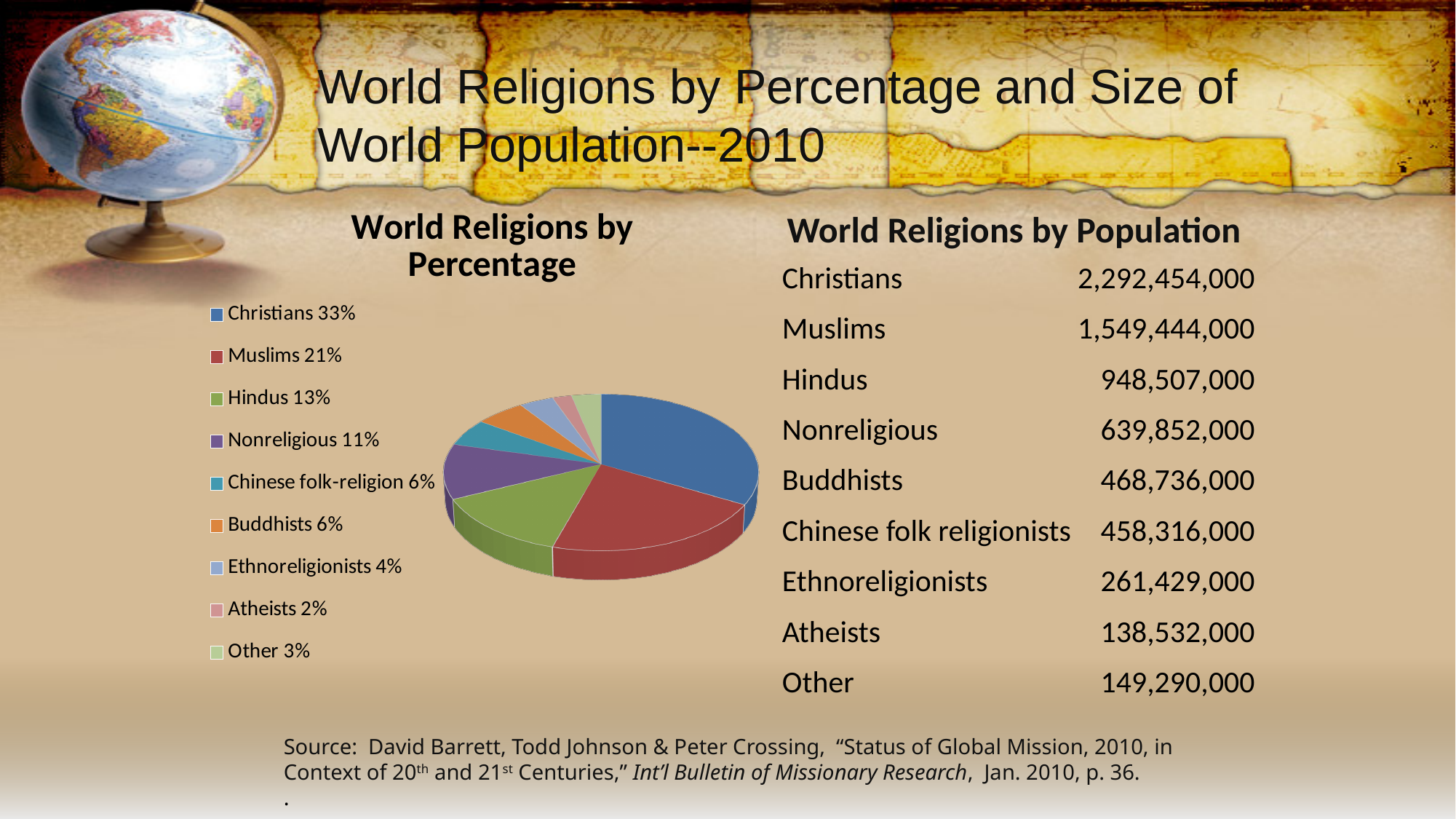
In the "World Religions by Percentage" pie chart, what percentage is shown for Christians? 33% What kind of chart is shown under the title "World Religions by Percentage"? pie chart Which category has the largest slice in the "World Religions by Percentage" pie chart? Christians In the "World Religions by Percentage" pie chart, what is the difference in percentage points between Christians and Muslims? 12 How many categories are listed in the legend of the "World Religions by Percentage" pie chart? 9 In the "World Religions by Percentage" pie chart, what percentage is shown for Nonreligious? 11% In the "World Religions by Percentage" pie chart, what percentage is shown for Muslims? 21% In the "World Religions by Percentage" pie chart, what percentage is shown for Ethnoreligionists? 4% Which category has the smallest slice in the "World Religions by Percentage" pie chart? Atheists In the "World Religions by Percentage" pie chart, what colour is the Christians slice? blue In the "World Religions by Percentage" pie chart, which is larger, the Hindus slice or the Nonreligious slice? Hindus In the "World Religions by Percentage" pie chart, what is the combined percentage of Buddhists and Chinese folk-religion? 12%